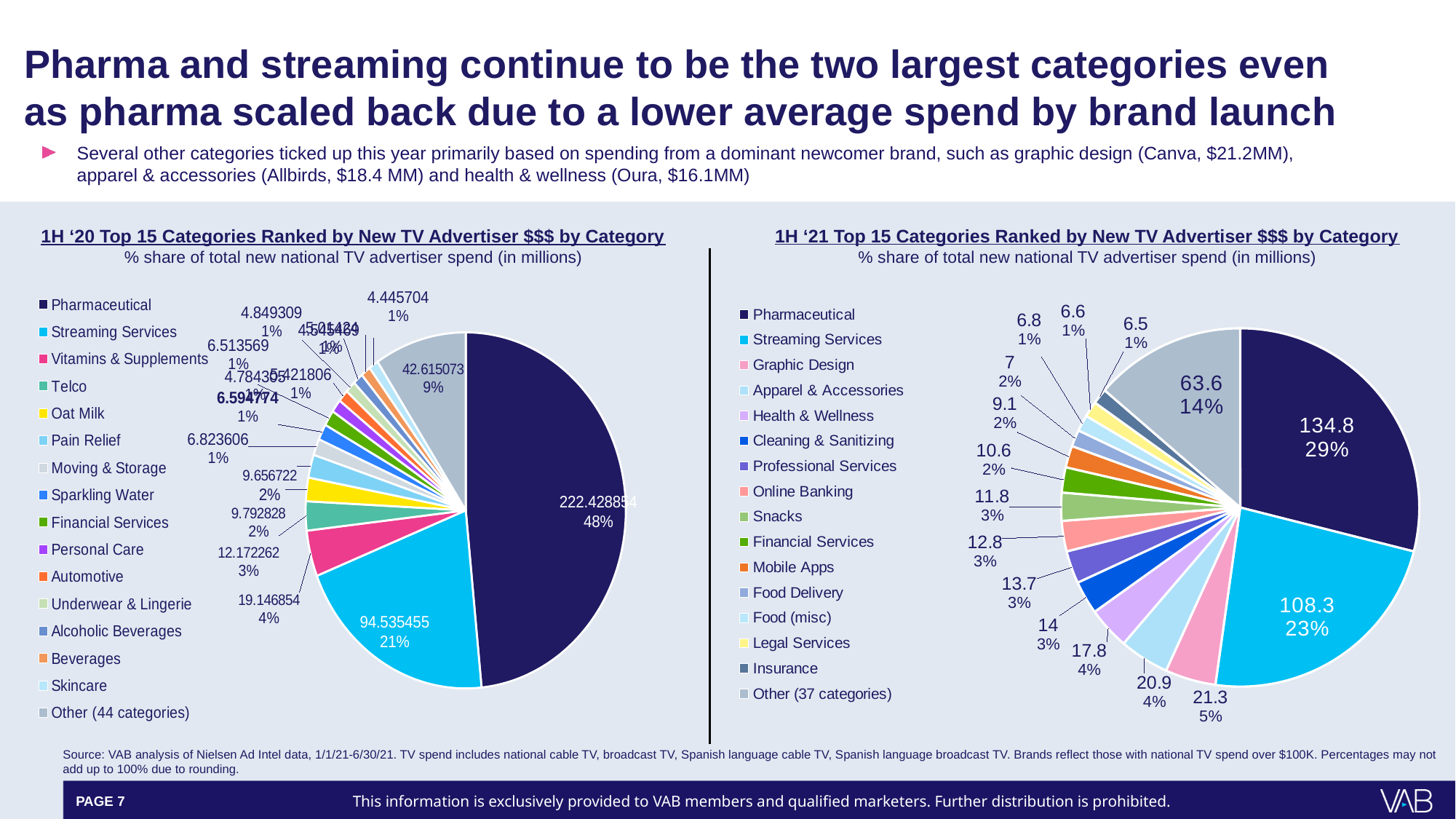
In the 1H '21 chart on the right, what is the value for Graphic Design? 21.3 In the 1H '21 chart on the right, what share of the pie does Streaming Services hold? 23% What type of chart is used on the left side of the slide for 1H '20? Pie chart In the 1H '21 chart on the right, which is larger, Apparel & Accessories or Health & Wellness? Apparel & Accessories In the 1H '20 chart on the left, what is the value for Pharmaceutical? 222.428854 In the 1H '20 chart on the left, what share of the pie does Streaming Services hold? 21% How many entries does the legend of the 1H '21 chart on the right list? 16 In the 1H '21 chart on the right, which category has the smallest slice? Insurance In the 1H '21 chart on the right, which category has the largest slice? Pharmaceutical In the 1H '21 chart on the right, what is the difference between the Pharmaceutical and Streaming Services values? 26.5 In the 1H '21 chart on the right, what is the value for Pharmaceutical? 134.8 In the 1H '21 chart on the right, what is the value for Other (37 categories)? 63.6